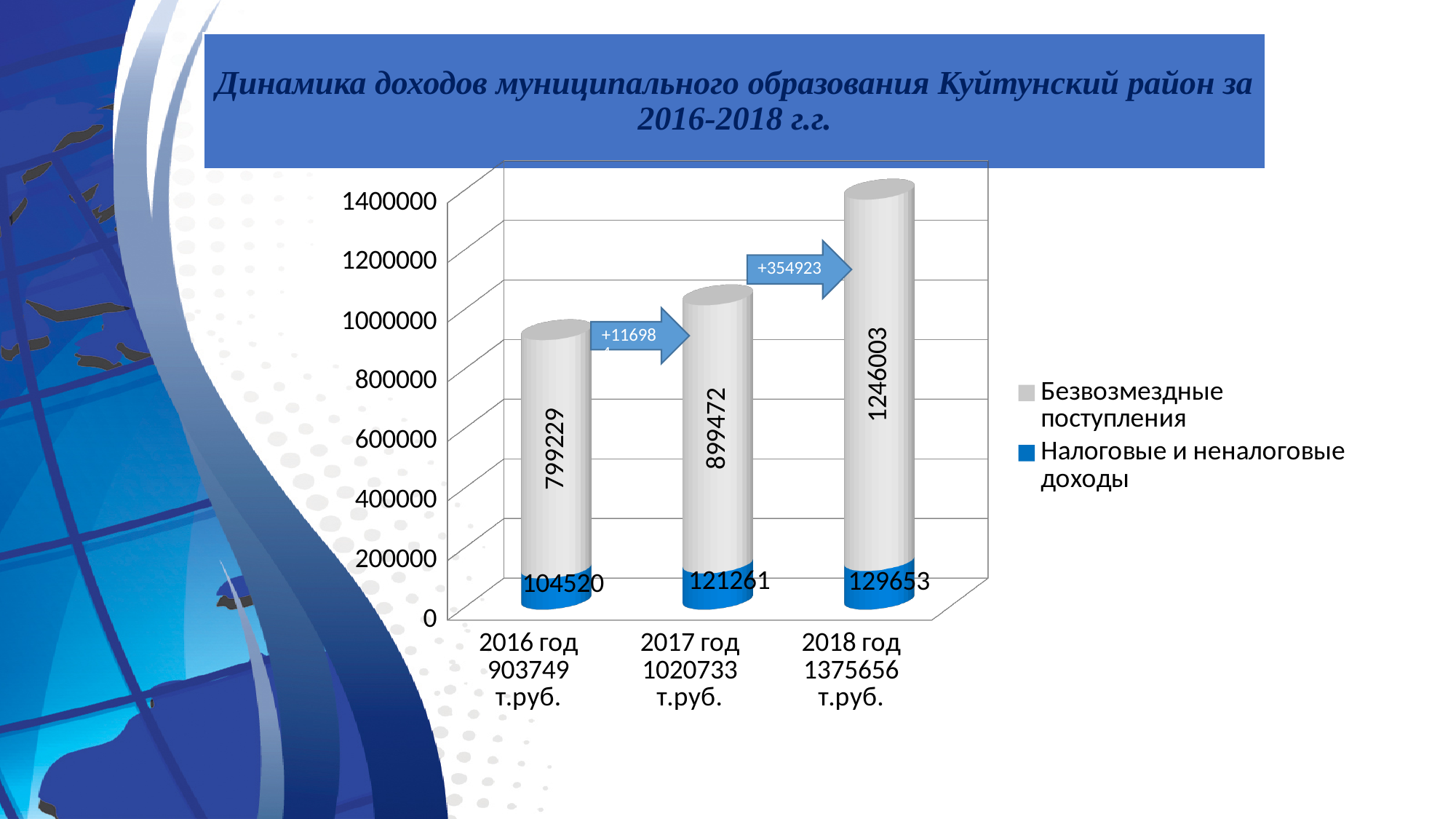
What is the difference between Безвозмездные поступления in 2018 год and 2017 год? 346531 Which year has the highest value of Безвозмездные поступления? 2018 год What is the value of Безвозмездные поступления for 2016 год? 799229 Which is larger: Налоговые и неналоговые доходы in 2017 год or in 2016 год? 2017 год What is the value of Налоговые и неналоговые доходы for 2018 год? 129653 How many years (categories) are shown on the x axis? 3 How many series does the legend list? 2 What is the total of the stacked bar for 2017 год? 1020733 Which year has the lowest value of Налоговые и неналоговые доходы? 2016 год Do the total revenues rise or fall from 2016 год to 2018 год? rise What is the total of the stacked bar for 2018 год? 1375656 What is the value of Налоговые и неналоговые доходы for 2017 год? 121261